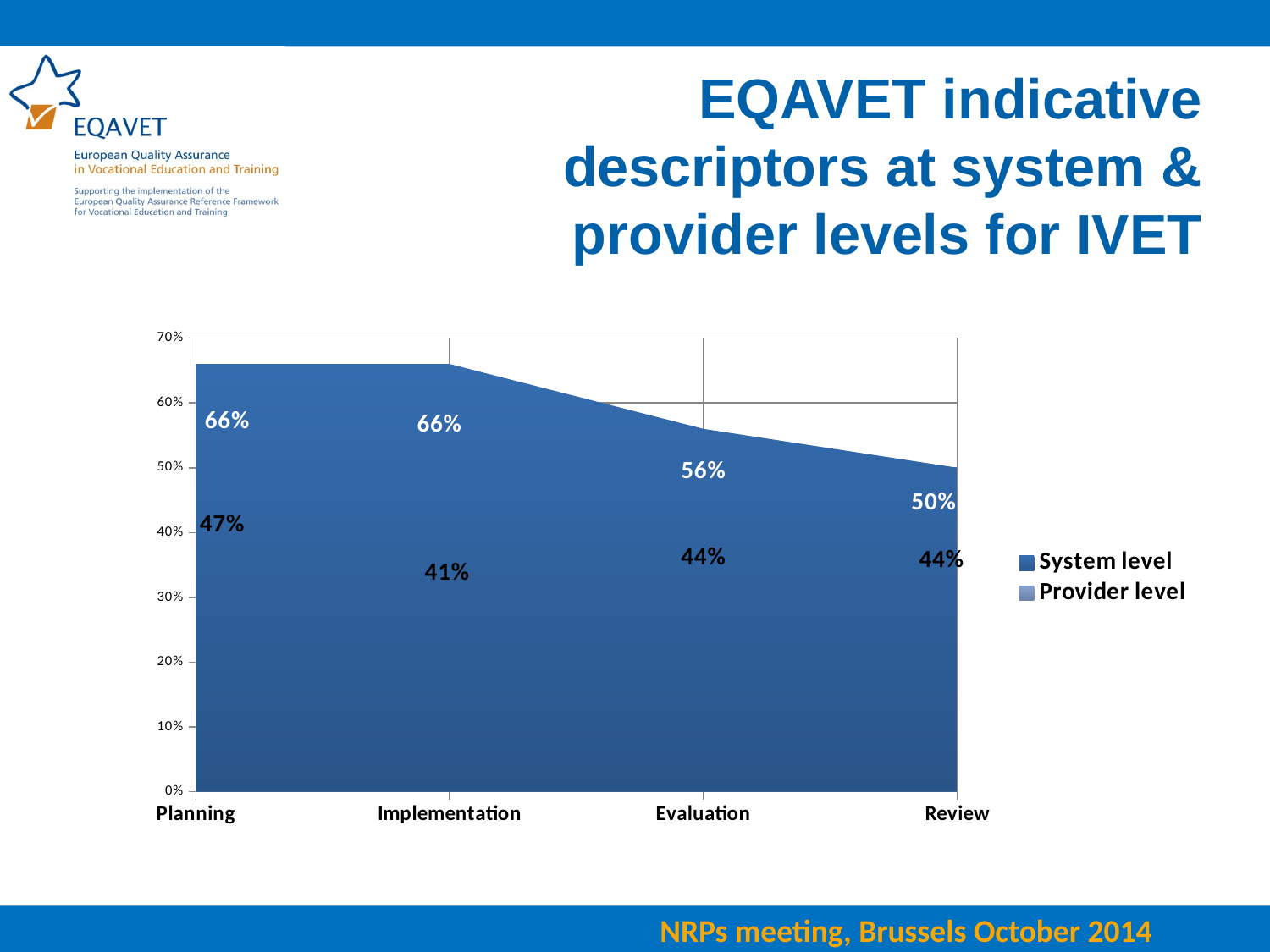
What kind of chart is shown on the slide? Area chart How many series does the legend list? 2 What is the System level value for Review? 50% Which category has the lowest System level value? Review Which category has the highest Provider level value? Planning What are the two series named in the legend? System level and Provider level What is the Provider level value for Implementation? 41% What is the System level value for Evaluation? 56% Does the System level value rise or fall from Implementation to Review? Fall How many categories are shown on the x axis? 4 What is the difference between the System level and Provider level values for Planning? 19% Is the System level value for Planning larger or the System level value for Review? Planning